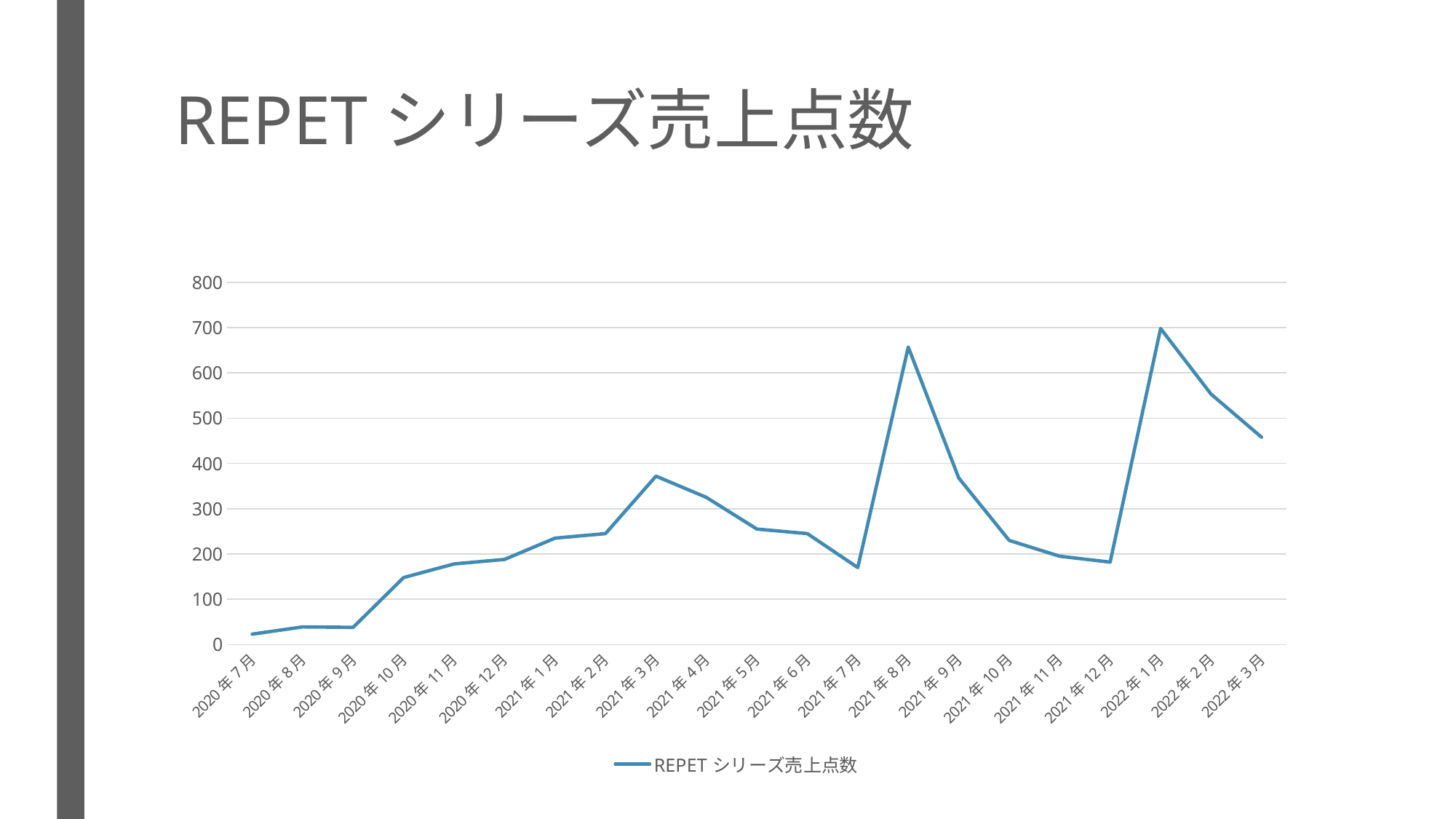
Which is larger, the value for 2022年2月 or the value for 2021年4月? 2022年2月 Is the value for 2020年10月 greater or less than 100? greater Is the value for 2022年3月 greater or less than 500? less What kind of chart is shown on the slide? line chart How many months are plotted along the x axis? 21 Which month has the lowest value? 2020年7月 Is the value for 2021年8月 greater or less than 600? greater Which month has the highest value? 2022年1月 What is the title of the chart on the slide? REPET シリーズ売上点数 How many series does the legend list? 1 Do the values rise or fall from 2022年1月 to 2022年3月? fall